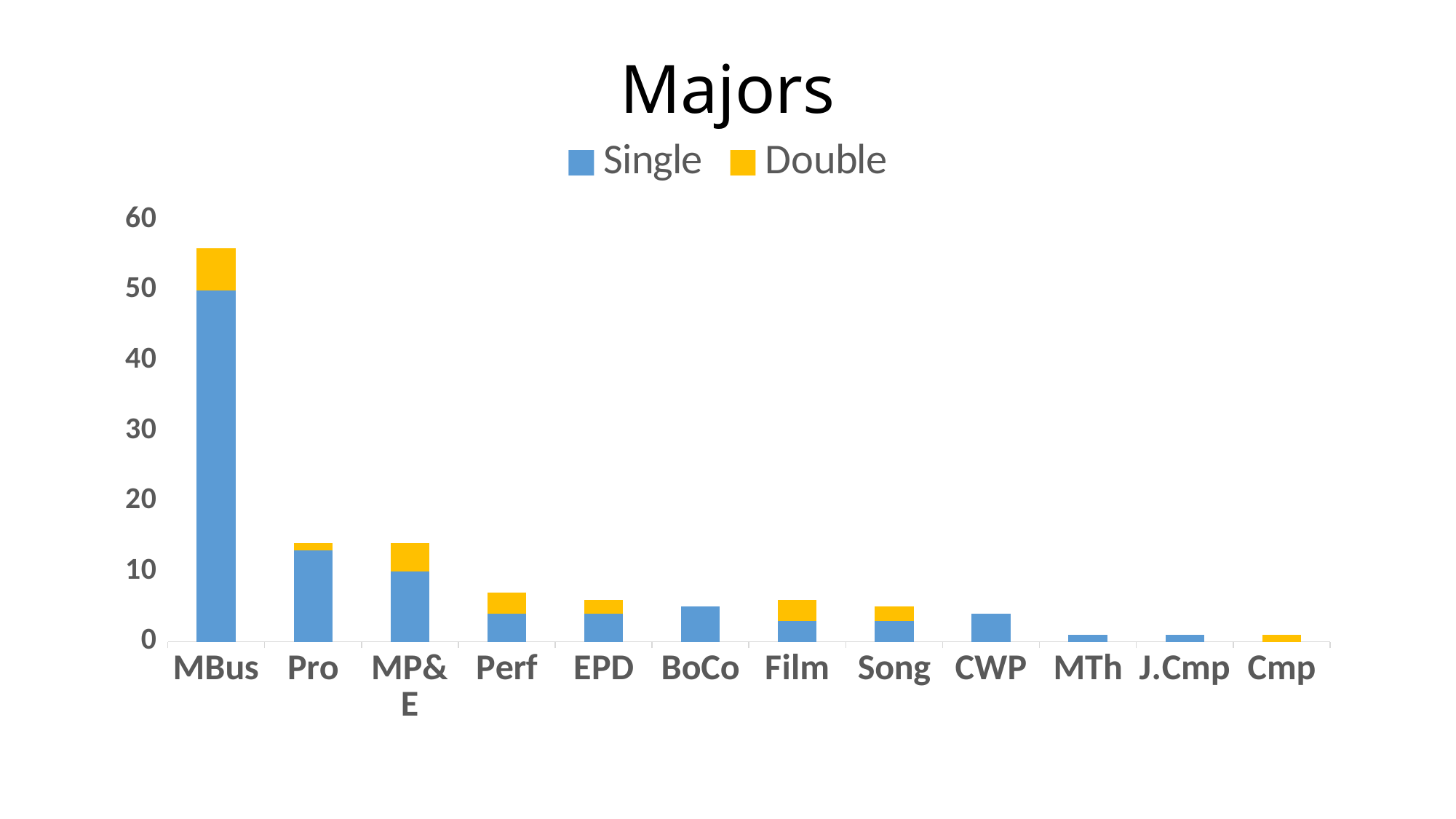
How many majors (categories) are shown on the x axis? 12 How many series does the legend list? 2 Which series is shown in yellow in the legend? Double Is the value for CWP greater or less than 10? less What kind of chart is shown on the slide? Stacked bar chart Is the total bar height for MBus greater or less than 50? greater Is the total bar height for Perf greater or less than 10? less Which major has the tallest bar overall? MBus Which has a taller total bar, MBus or Pro? MBus What is the title of the chart? Majors